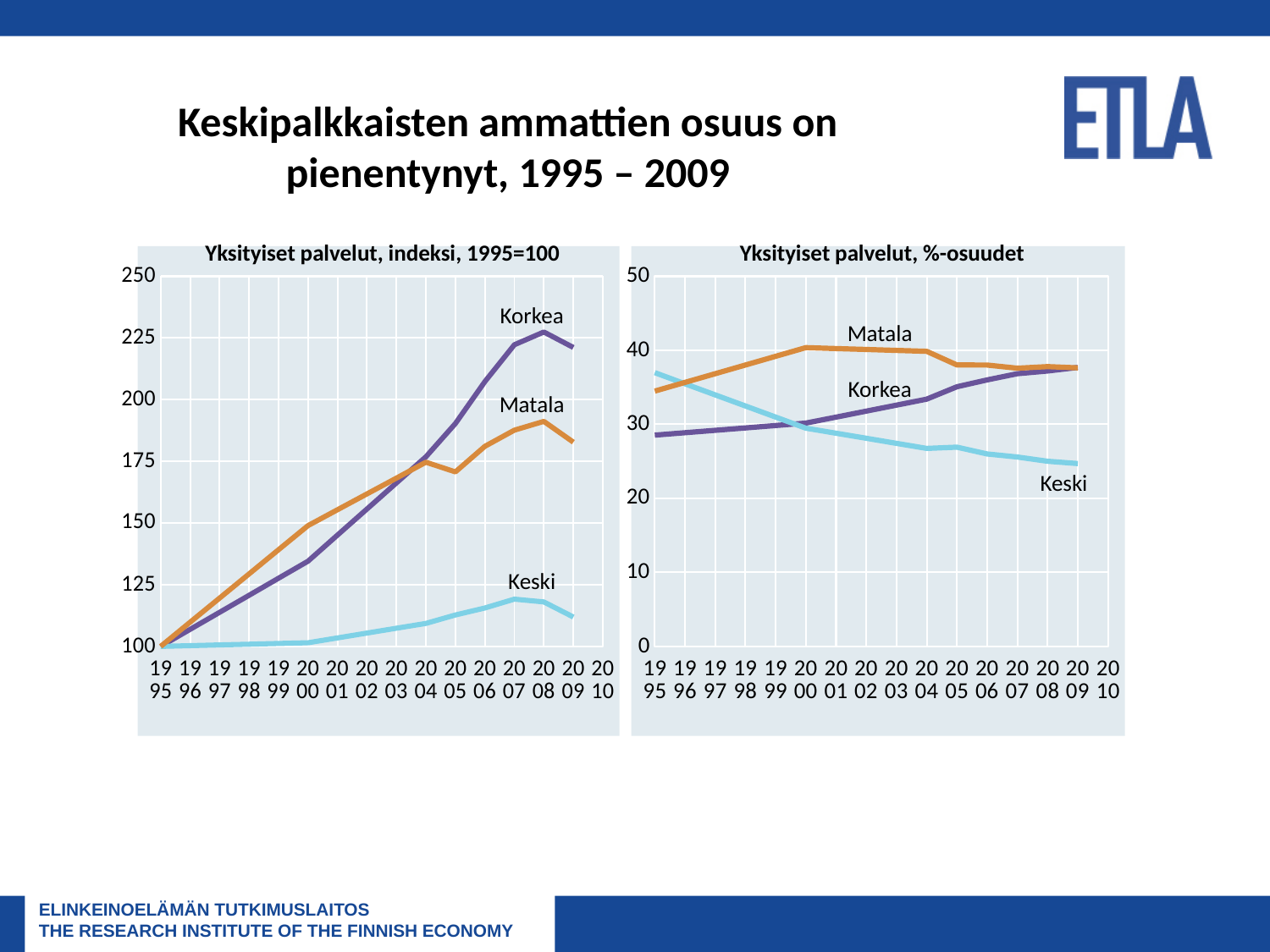
In the left chart (indeksi, 1995=100), is the value for Korkea in 2008 greater or less than 200? greater What kind of chart is the left chart, 'Yksityiset palvelut, indeksi, 1995=100'? line chart How many series are plotted in the right chart, 'Yksityiset palvelut, %-osuudet'? 3 In the left chart (indeksi, 1995=100), which series is highest in 2009? Korkea In the right chart (%-osuudet), is the value for Keski in 2009 greater or less than 30? less In the left chart (indeksi, 1995=100), is the value for Keski in 2009 greater or less than 125? less In the left chart (indeksi, 1995=100), does the Korkea series generally rise or fall from 1995 to 2008? rise In the left chart (indeksi, 1995=100), what is the index value of all three series in 1995? 100 In the right chart (%-osuudet), does the Keski series rise or fall from 1995 to 2009? fall In the left chart (indeksi, 1995=100), which series is lowest in 2009? Keski In the right chart (%-osuudet), which is larger in 2005, Matala or Keski? Matala In the right chart (%-osuudet), which series is highest in 1995? Keski